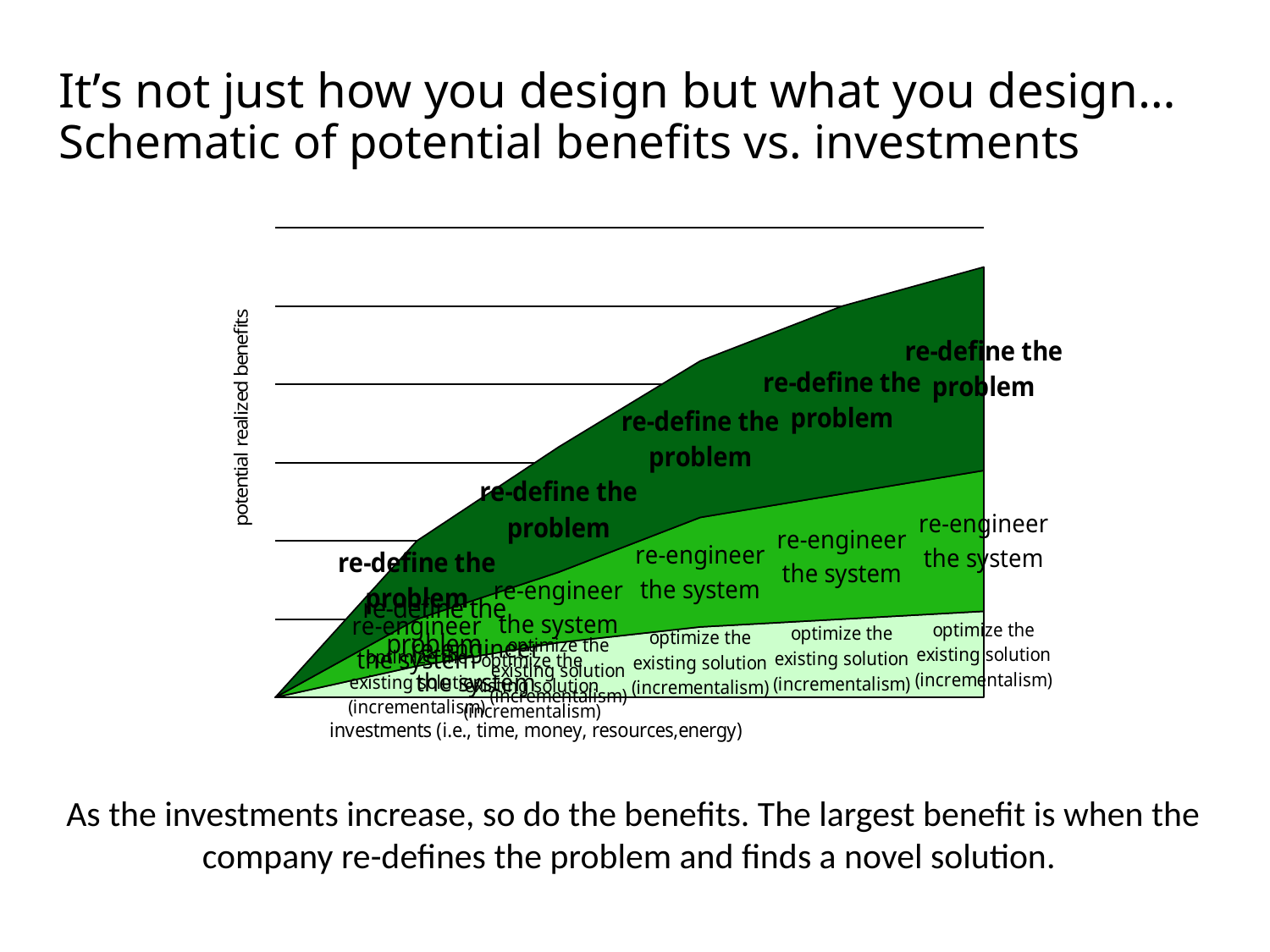
Which layer of the chart is the thinnest at the right-hand end? optimize the existing solution (incrementalism) What kind of chart is shown on the slide? Area chart What is the label of the chart's horizontal axis? investments (i.e., time, money, resources,energy) Do the potential realized benefits rise or fall as investments increase along the x axis? Rise Which layer is at the bottom of the stacked chart? optimize the existing solution (incrementalism) At the right-hand end of the chart, which layer is thicker: 're-engineer the system' or 'optimize the existing solution'? re-engineer the system Which layer of the chart is the thickest at the right-hand end? re-define the problem Which layer is at the top of the stacked chart? re-define the problem What is the label of the chart's vertical axis? potential realized benefits How many stacked layers (strategies) does the chart show? 3